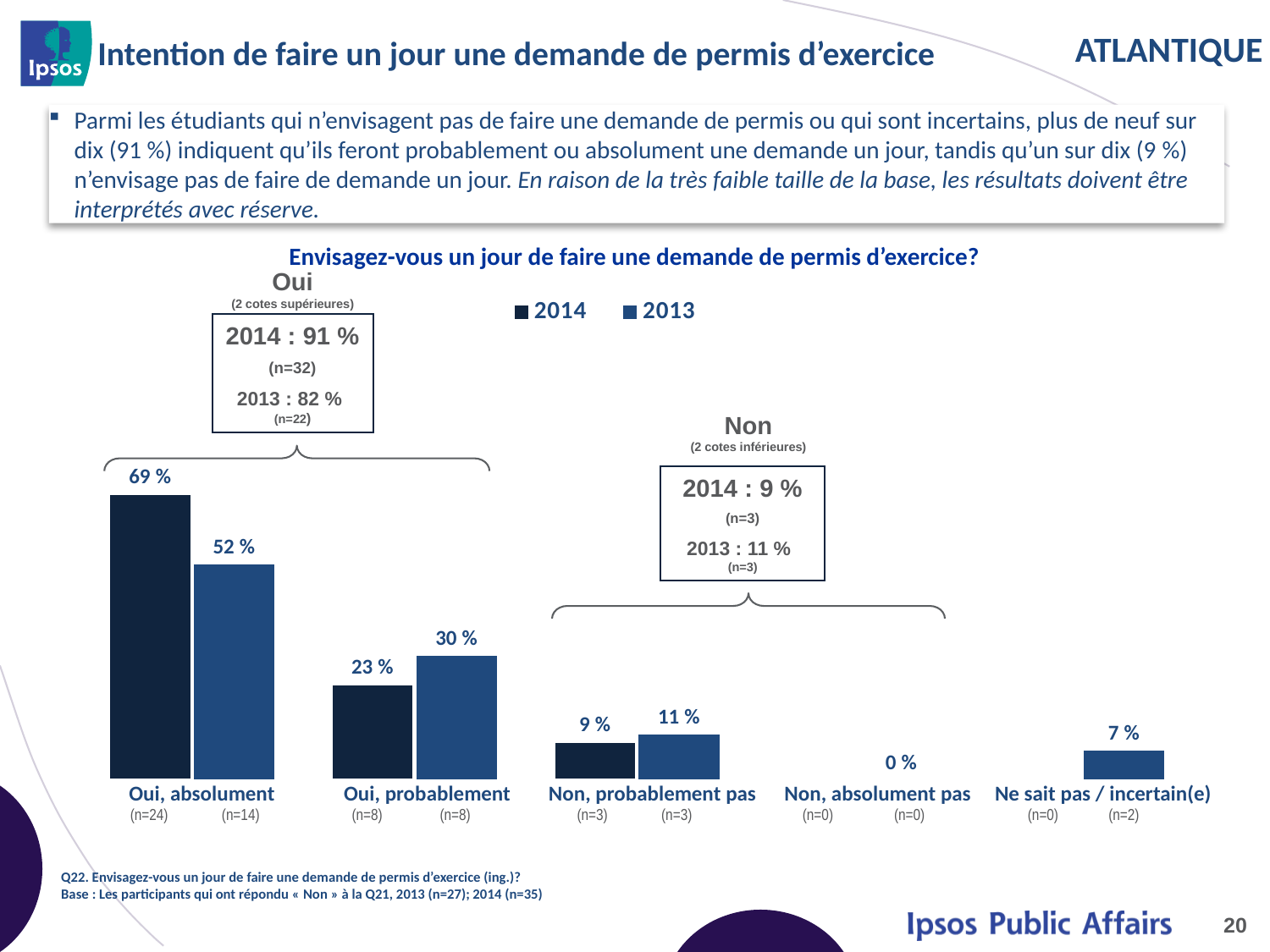
Which category has the highest 2014 value? Oui, absolument What is the difference between the 2013 and 2014 values for "Oui, probablement"? 7 % How many categories are shown on the x axis? 5 What is the 2014 value for "Oui, absolument"? 69 % How many series does the legend list? 2 What is the difference between the 2014 and 2013 values for "Oui, absolument"? 17 % What is the 2013 value for "Ne sait pas / incertain(e)"? 7 % What is the 2014 value for "Non, probablement pas"? 9 % Which is larger for "Oui, probablement": the 2014 value or the 2013 value? 2013 What kind of chart is shown on the slide? Bar chart What is the 2013 value for "Oui, absolument"? 52 % What is the 2013 value for "Oui, probablement"? 30 %